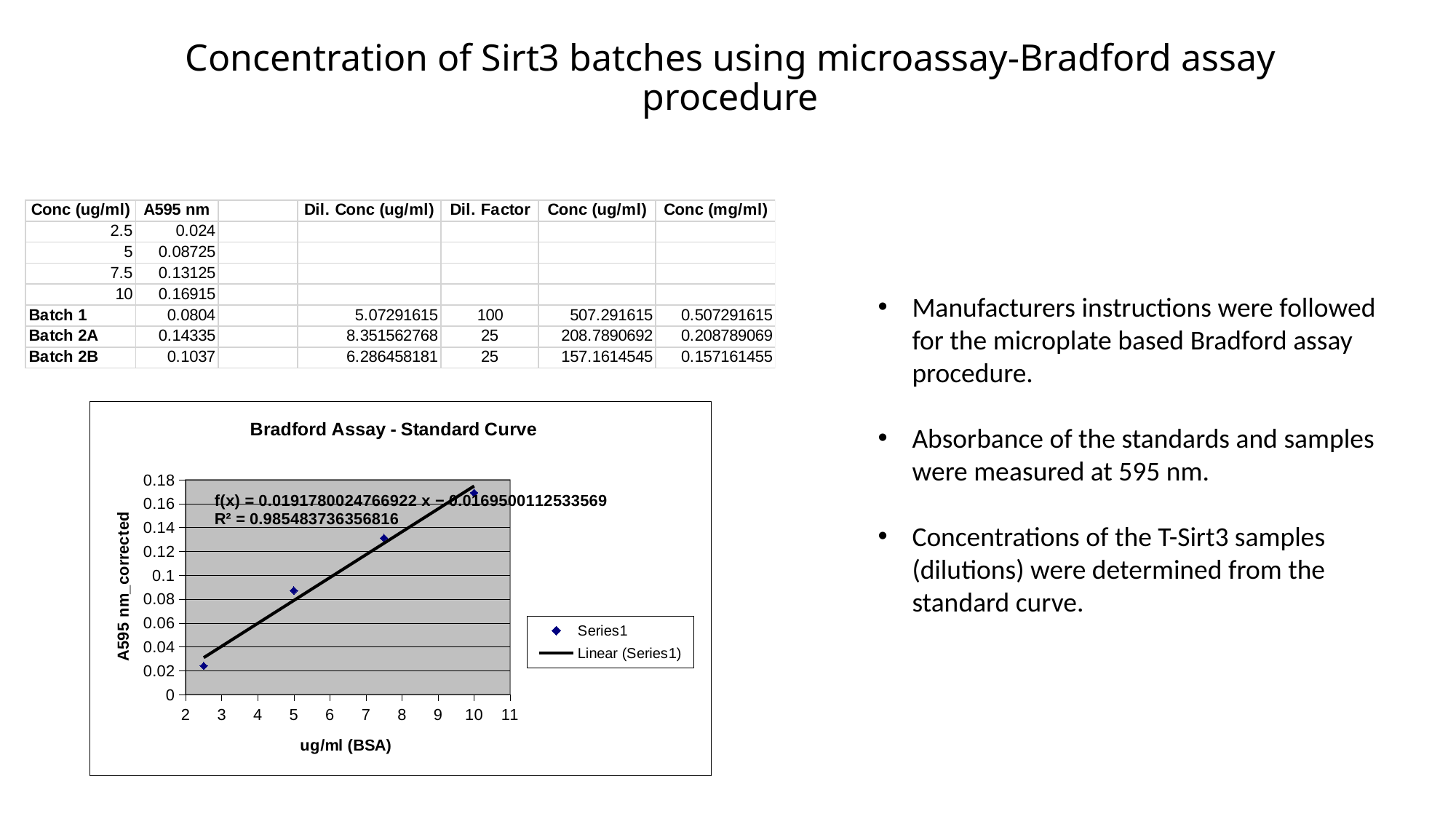
Is the plotted value at 10 ug/ml (BSA) greater or less than 0.14? greater Is the plotted point at 10 ug/ml (BSA) higher or lower than the point at 5 ug/ml (BSA)? higher Do the plotted values rise or fall as ug/ml (BSA) increases along the x axis? rise What R² value is printed on the chart? 0.985483736356816 What is the title of the chart? Bradford Assay - Standard Curve At which x value (ug/ml BSA) is the highest plotted point? 10 Is the plotted value at 5 ug/ml (BSA) greater or less than 0.06? greater How many data points are plotted in the chart? 4 At which x value (ug/ml BSA) is the lowest plotted point? 2.5 What kind of chart is shown on the slide? scatter chart How many entries does the chart legend list? 2 Is the plotted value at the lowest x position greater or less than 0.04? less